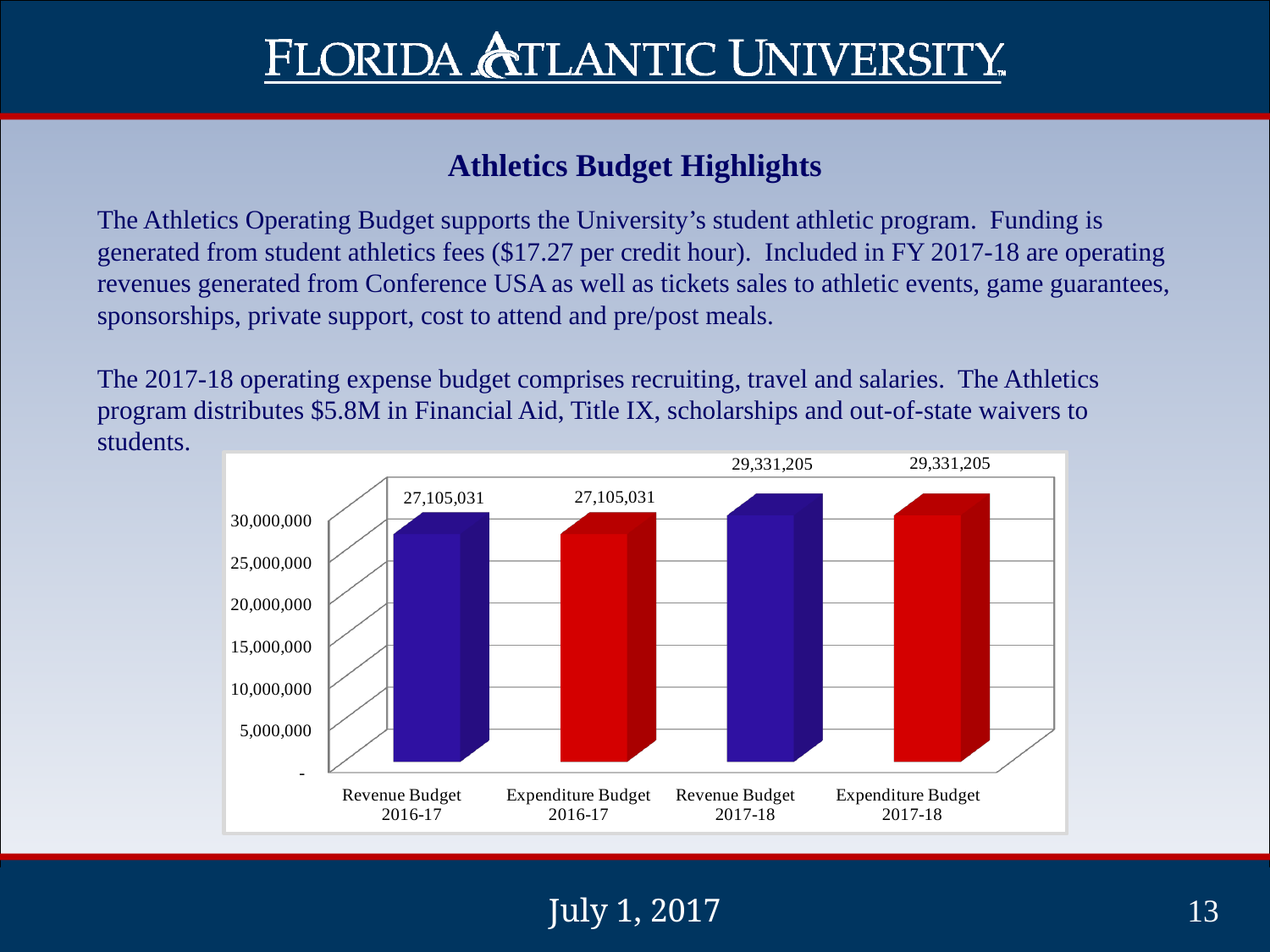
Is the value for Revenue Budget 2016-17 greater or less than 25,000,000? greater How many bars are shown in the chart? 4 What colour are the Revenue Budget bars? blue Do the values rise or fall from the 2016-17 bars to the 2017-18 bars? rise What is the highest value shown on the vertical axis? 30,000,000 What kind of chart is shown on the slide? bar chart Is the Revenue Budget 2016-17 equal to the Expenditure Budget 2016-17? Yes What is the value for Expenditure Budget 2017-18? 29,331,205 Which is larger, the Expenditure Budget 2016-17 or the Expenditure Budget 2017-18? Expenditure Budget 2017-18 What is the value for Revenue Budget 2016-17? 27,105,031 What is the difference between the Revenue Budget 2017-18 and the Revenue Budget 2016-17? 2,226,174 What is the value for Revenue Budget 2017-18? 29,331,205